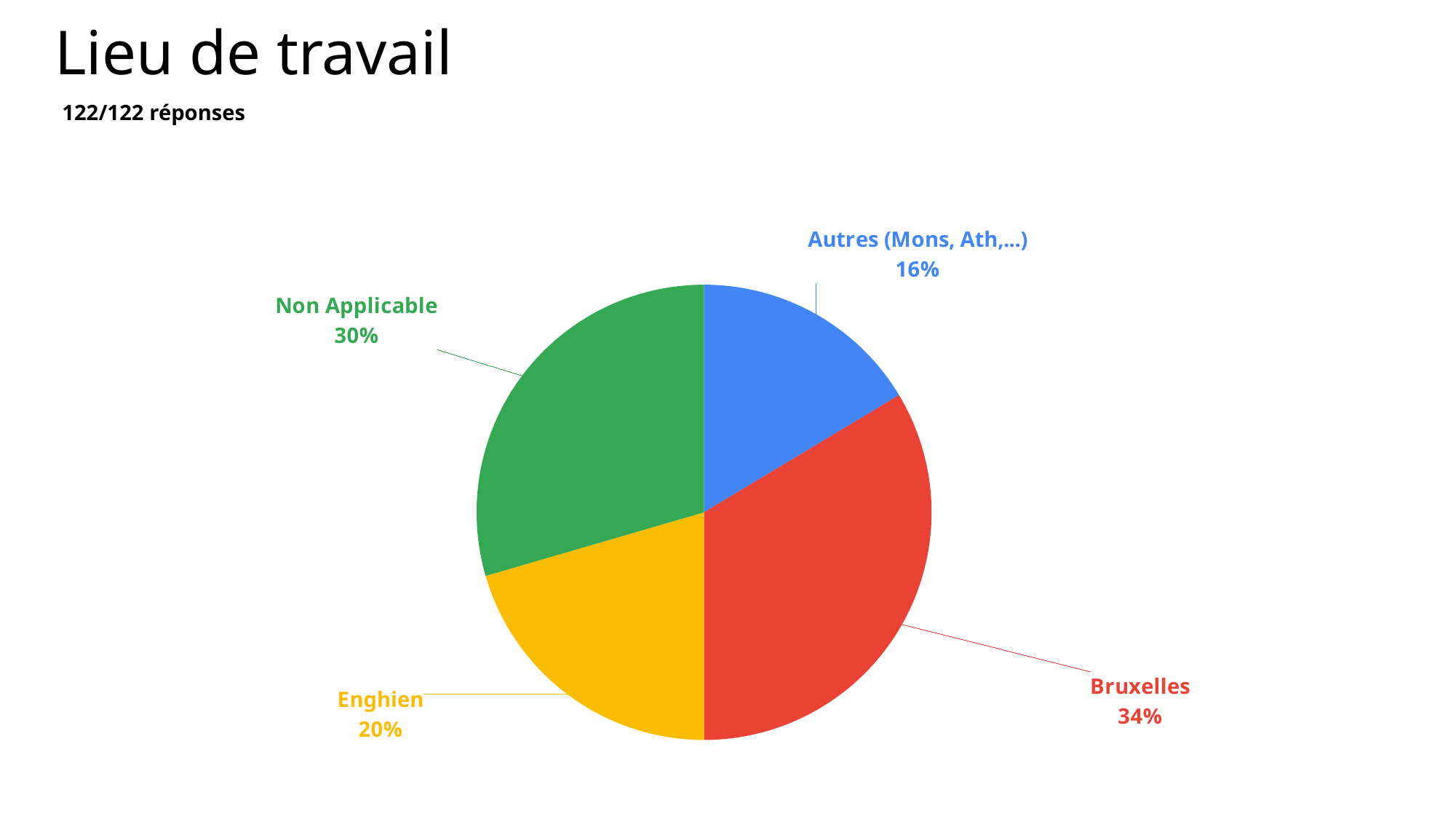
How many slices does the pie chart have? 4 Which category has the largest slice of the pie? Bruxelles Which category has the smallest slice of the pie? Autres (Mons, Ath,...) What type of chart is shown on the slide? pie chart What is the title of the slide containing the chart? Lieu de travail What is the difference in percentage points between Bruxelles and Enghien? 14 What percentage is shown for Autres (Mons, Ath,...)? 16% What share of the pie is labelled Non Applicable? 30% Which is larger, the share for Non Applicable or the share for Enghien? Non Applicable How many responses does the slide say the chart is based on? 122/122 réponses What percentage of respondents work in Enghien? 20% What percentage of respondents work in Bruxelles? 34%